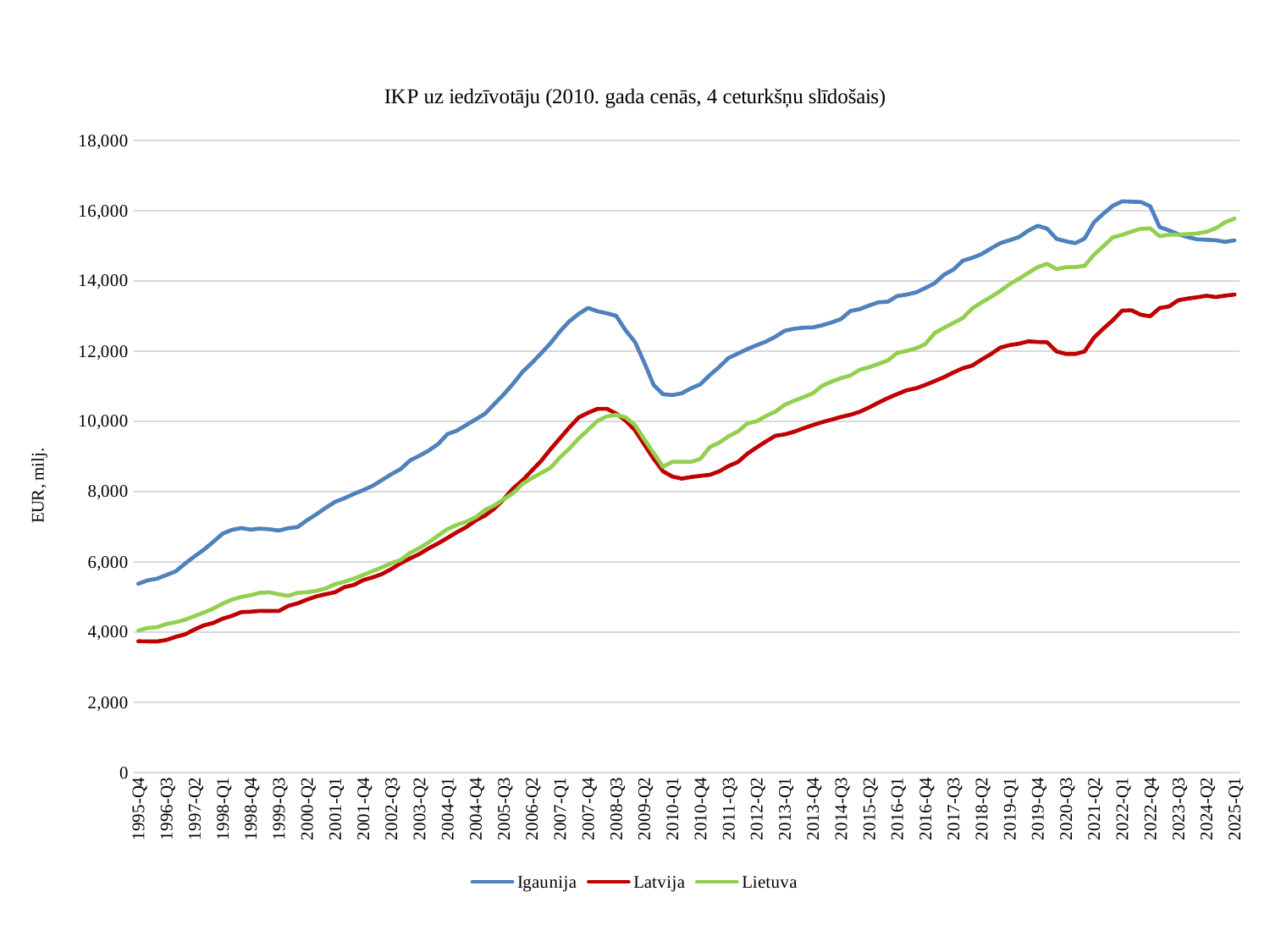
At 2025-Q1, which is larger: the value for Lietuva or the value for Igaunija? Lietuva Does the value for Igaunija rise or fall between 2008-Q3 and 2010-Q1? fall What kind of chart is shown on the slide? line chart Is the value for Lietuva at 2025-Q1 greater or less than 14,000? greater Is the value for Latvija at 2025-Q1 greater or less than 12,000? greater What is the title of the chart? IKP uz iedzīvotāju (2010. gada cenās, 4 ceturkšņu slīdošais) Is the value for Igaunija at 1995-Q4 greater or less than 6,000? less At 2019-Q4, which is larger: the value for Igaunija or the value for Lietuva? Igaunija Which series has the highest value at 2010-Q1? Igaunija What is the label on the vertical axis? EUR, milj. Which series has the lowest value at 2025-Q1? Latvija How many series does the legend list? 3